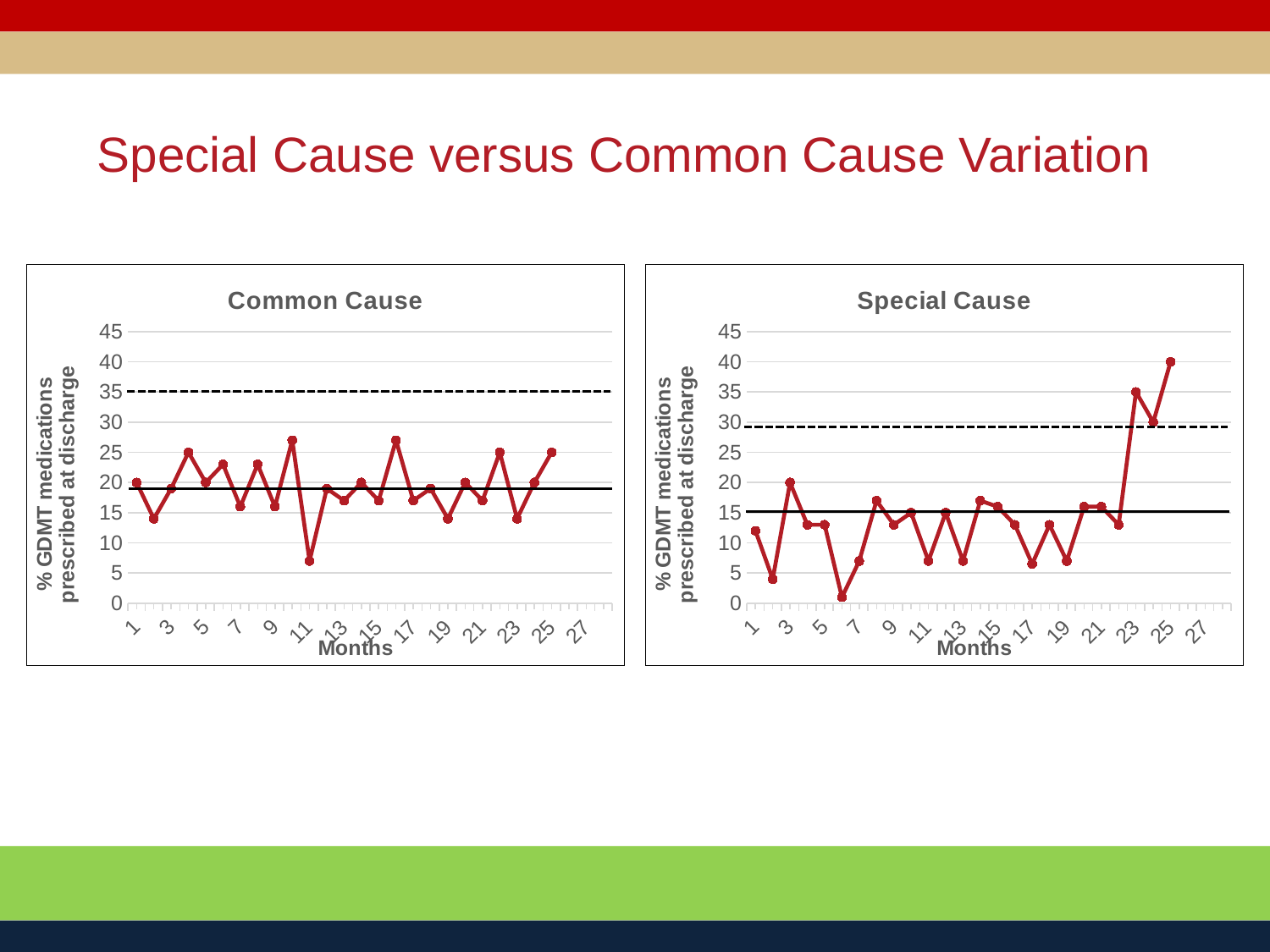
In the Common Cause chart, is the value for month 11 greater or less than 10? less What is the x-axis label on the Special Cause chart? Months In the Special Cause chart, is the value for month 23 greater or less than 30? greater In the Special Cause chart, is the value for month 25 larger than the value for month 1? yes In the Special Cause chart, which month has the highest value? 25 In the Special Cause chart, which month has the lowest value? 6 What kind of chart is the Common Cause chart? line chart What kind of chart is the Special Cause chart? line chart What is the y-axis label on the Common Cause chart? % GDMT medications prescribed at discharge In the Common Cause chart, is the value for month 16 greater or less than 25? greater In the Common Cause chart, which month has the lowest value? 11